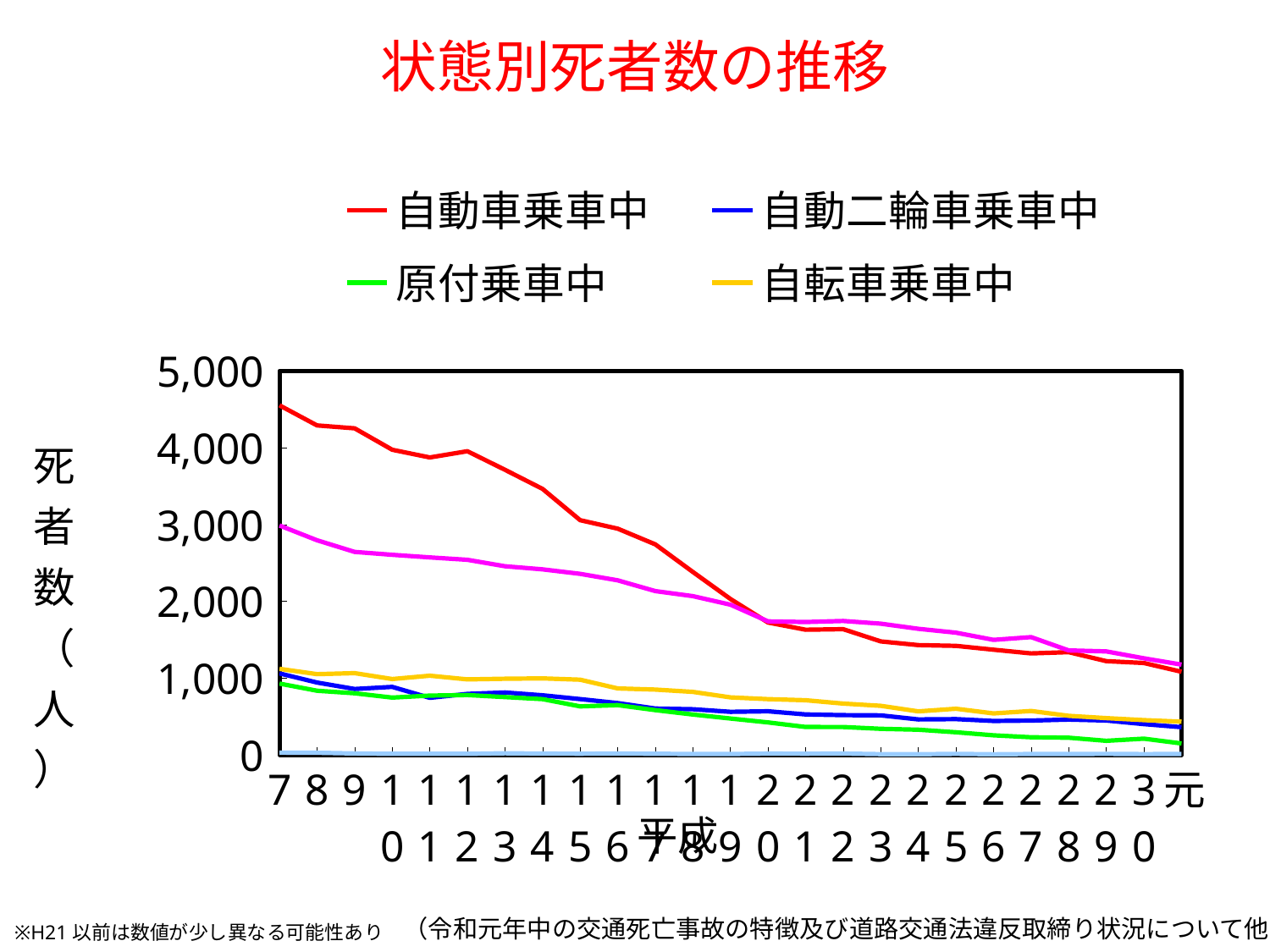
Which of the legend series has the lowest value in 令和元? 原付乗車中 Is the value for 自動車乗車中 in 令和元 greater or less than 2,000? less What is the title of the chart? 状態別死者数の推移 Is the value for 自動車乗車中 in 平成7 greater or less than 4,000? greater Does the value for 自転車乗車中 rise or fall overall along the x axis? fall What colour is the line for 自動車乗車中? red Which of the legend series has the highest value in 平成7? 自動車乗車中 Is the value for 原付乗車中 in 令和元 greater or less than 1,000? less How many series does the legend list? 4 What kind of chart is shown on the slide? line chart Does the value for 自動車乗車中 rise or fall from 平成7 to 令和元? fall In 平成7, which is larger: 自動車乗車中 or 自転車乗車中? 自動車乗車中